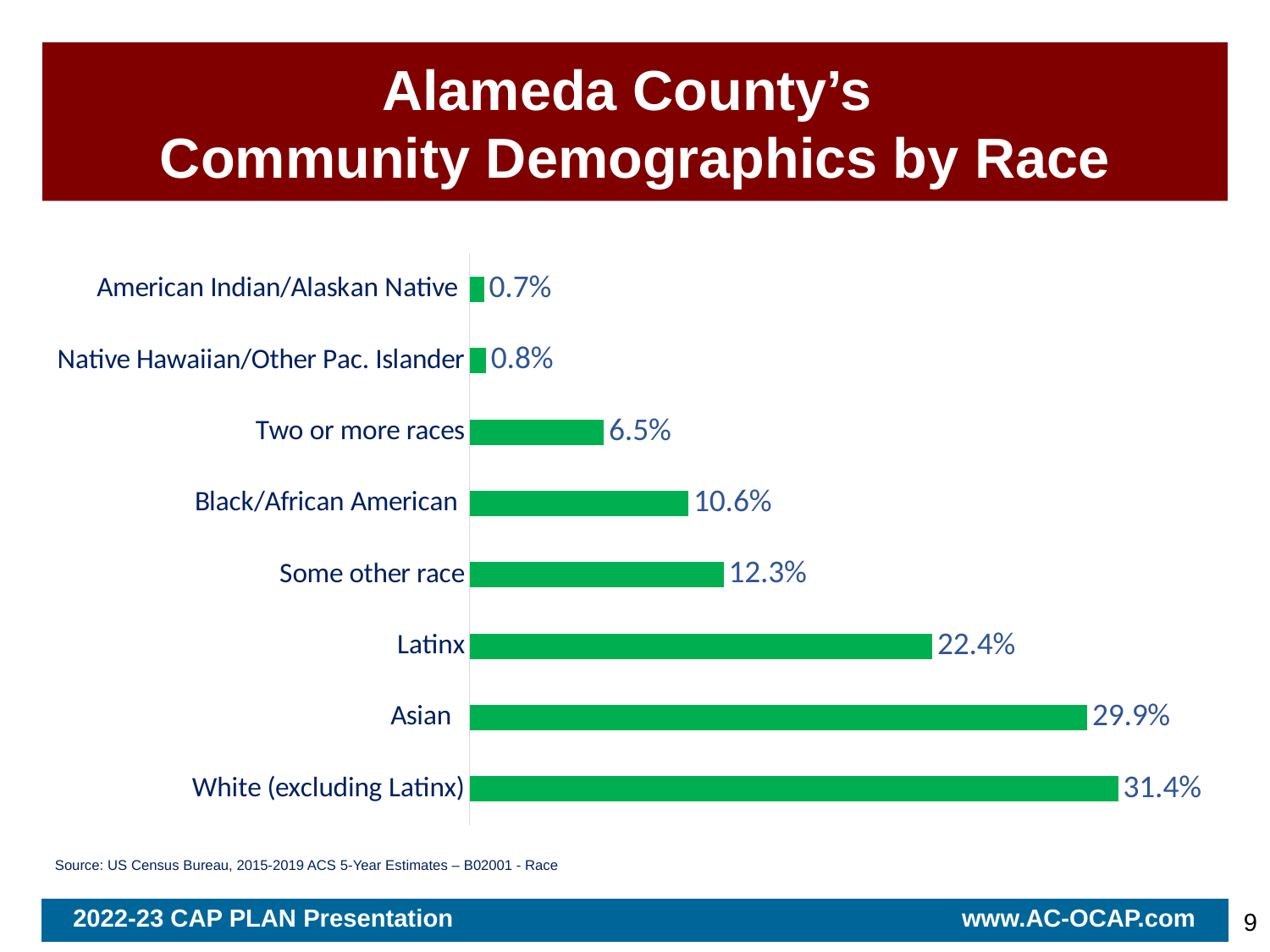
Which is larger, the value for Latinx or the value for Black/African American? Latinx Which category has the lowest value? American Indian/Alaskan Native How many categories are shown in the chart? 8 What is the value for Black/African American? 10.6% What is the value for Asian? 29.9% What is the value for Two or more races? 6.5% What is the difference between the values for Latinx and Some other race? 10.1% What kind of chart is shown on the slide? Bar chart Which category has the highest value? White (excluding Latinx) What is the difference between the values for White (excluding Latinx) and Asian? 1.5% What colour are the bars in the chart? Green What is the value for Native Hawaiian/Other Pac. Islander? 0.8%